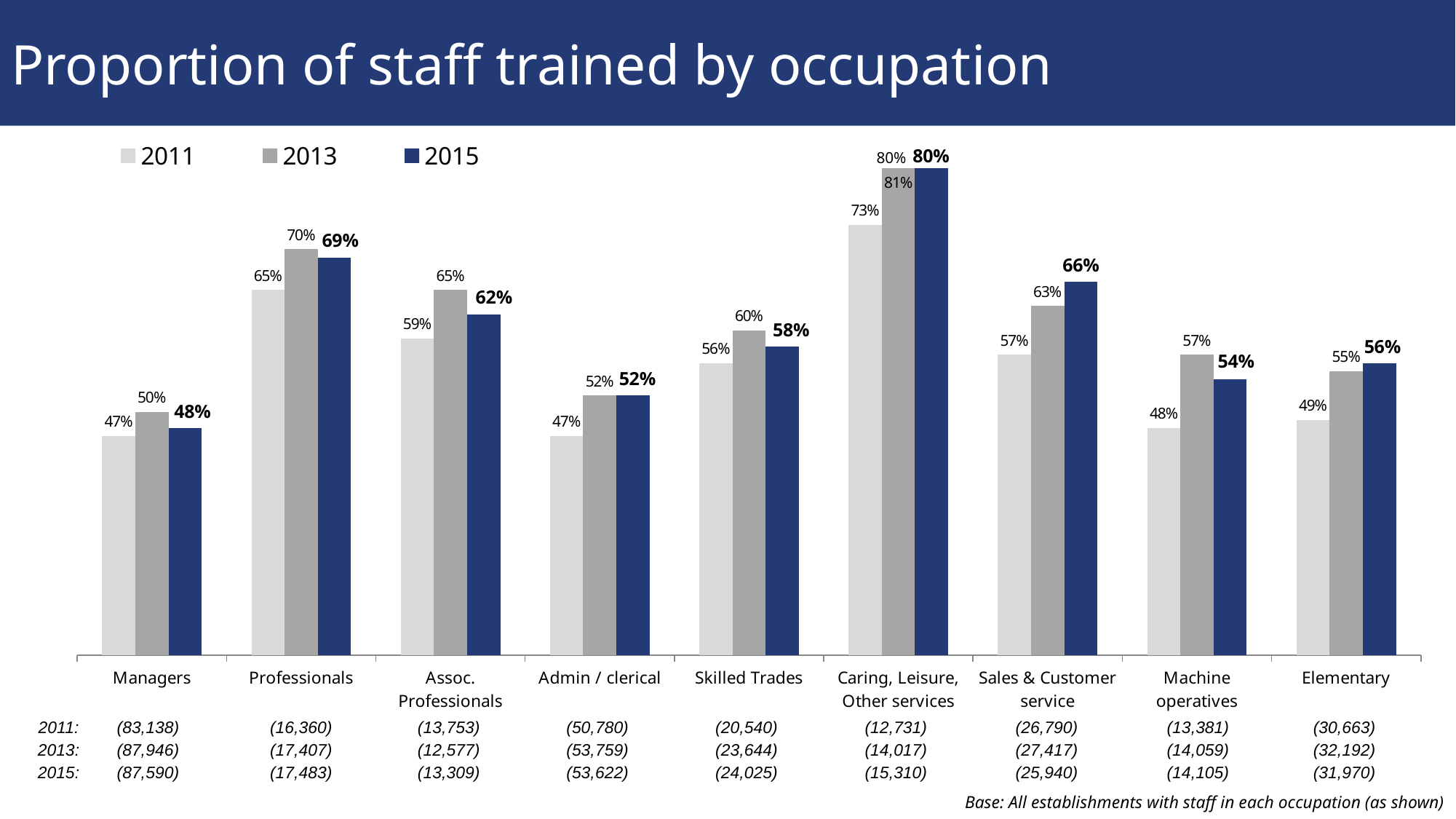
What type of chart is shown on the slide? Bar chart What is the 2013 value for Machine operatives? 57% How many series does the legend list? 3 What is the difference between the 2013 and 2011 values for Sales & Customer service? 6% Which occupation has the highest 2015 value? Caring, Leisure, Other services Which occupation has the lowest 2015 value? Managers What is the 2015 value for Professionals? 69% What is the 2011 value for Caring, Leisure, Other services? 73% How many occupation categories are shown on the x axis? 9 Do the values for Sales & Customer service rise or fall from 2011 to 2015? Rise Which is larger for Assoc. Professionals: the 2013 value or the 2015 value? 2013 What is the title of the chart? Proportion of staff trained by occupation